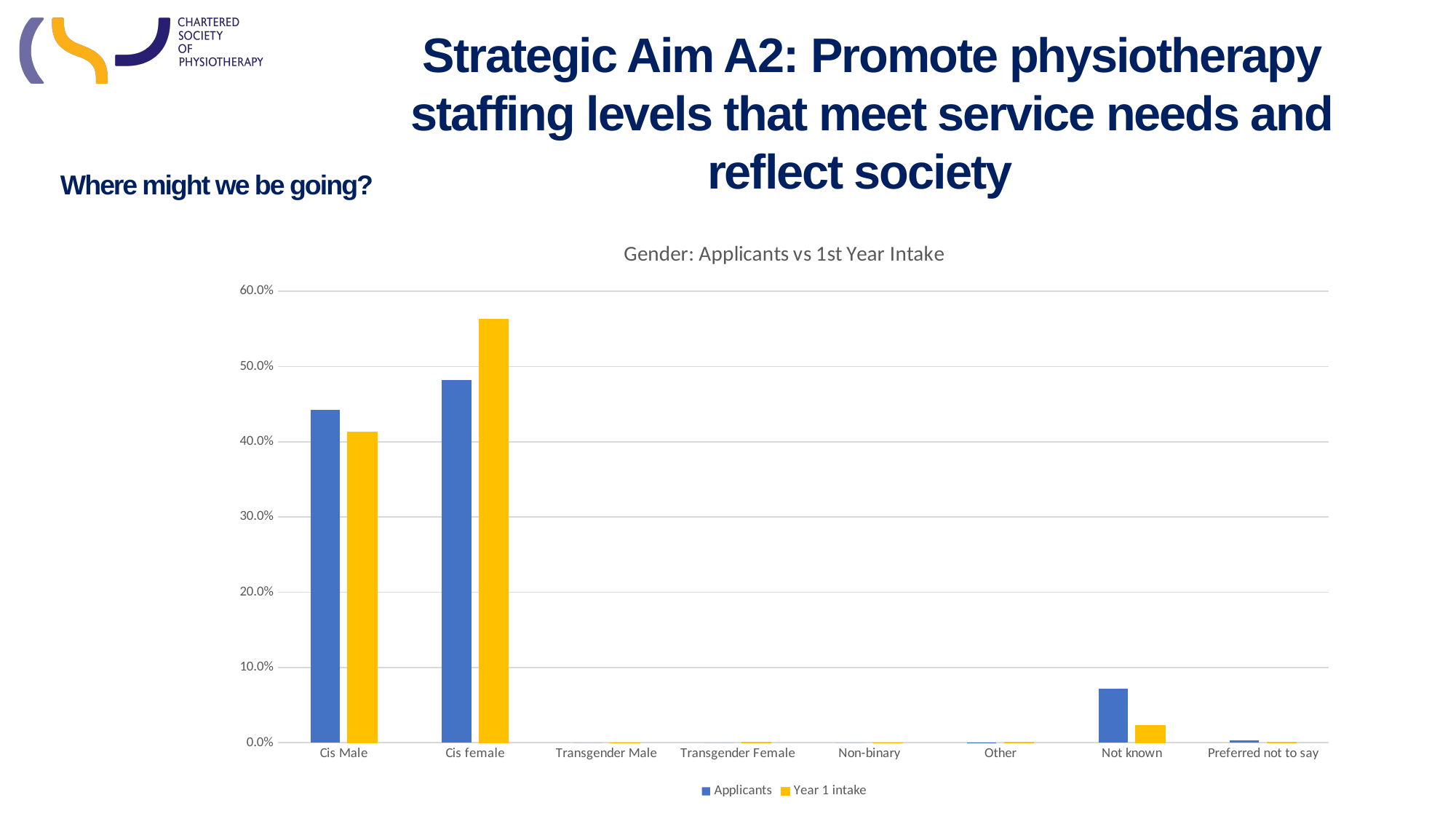
Which colour represents the Year 1 intake series? Yellow Is the Applicants value for Cis Male greater or less than 40.0%? greater How many series does the legend list? 2 For Cis female, which series has the larger value, Applicants or Year 1 intake? Year 1 intake How many gender categories are shown on the x axis? 8 Which category has the highest Applicants value? Cis female Which category has the highest Year 1 intake value? Cis female Is the Applicants value for Not known greater or less than 10.0%? less For Cis Male, which series has the larger value, Applicants or Year 1 intake? Applicants What kind of chart is shown on the slide? Bar chart What is the title of the chart? Gender: Applicants vs 1st Year Intake Is the Year 1 intake value for Cis female greater or less than 50.0%? greater